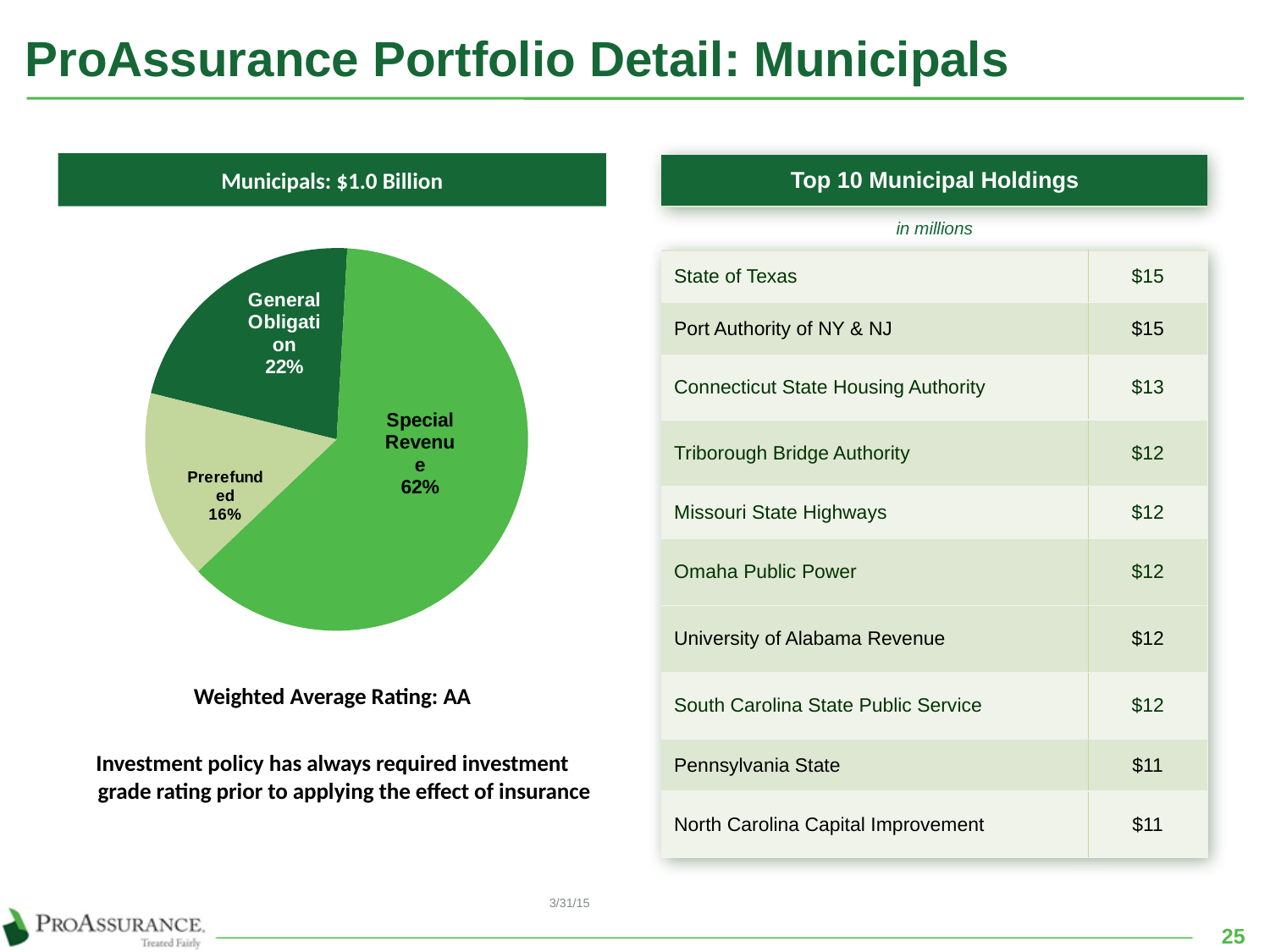
Which slice of the pie chart is the smallest? Prerefunded What type of chart is shown on the slide? pie chart Which slice of the pie chart is the largest? Special Revenue What is the title shown above the pie chart? Municipals: $1.0 Billion Which is larger in the pie chart, General Obligation or Prerefunded? General Obligation What share of the pie chart does Prerefunded represent? 16% What share of the pie chart does General Obligation represent? 22% What is the difference in percentage points between the Special Revenue and General Obligation slices? 40 What is the weighted average rating stated below the pie chart? AA How many slices does the pie chart have? 3 What is the difference in percentage points between the General Obligation and Prerefunded slices? 6 What share of the pie chart does Special Revenue represent? 62%